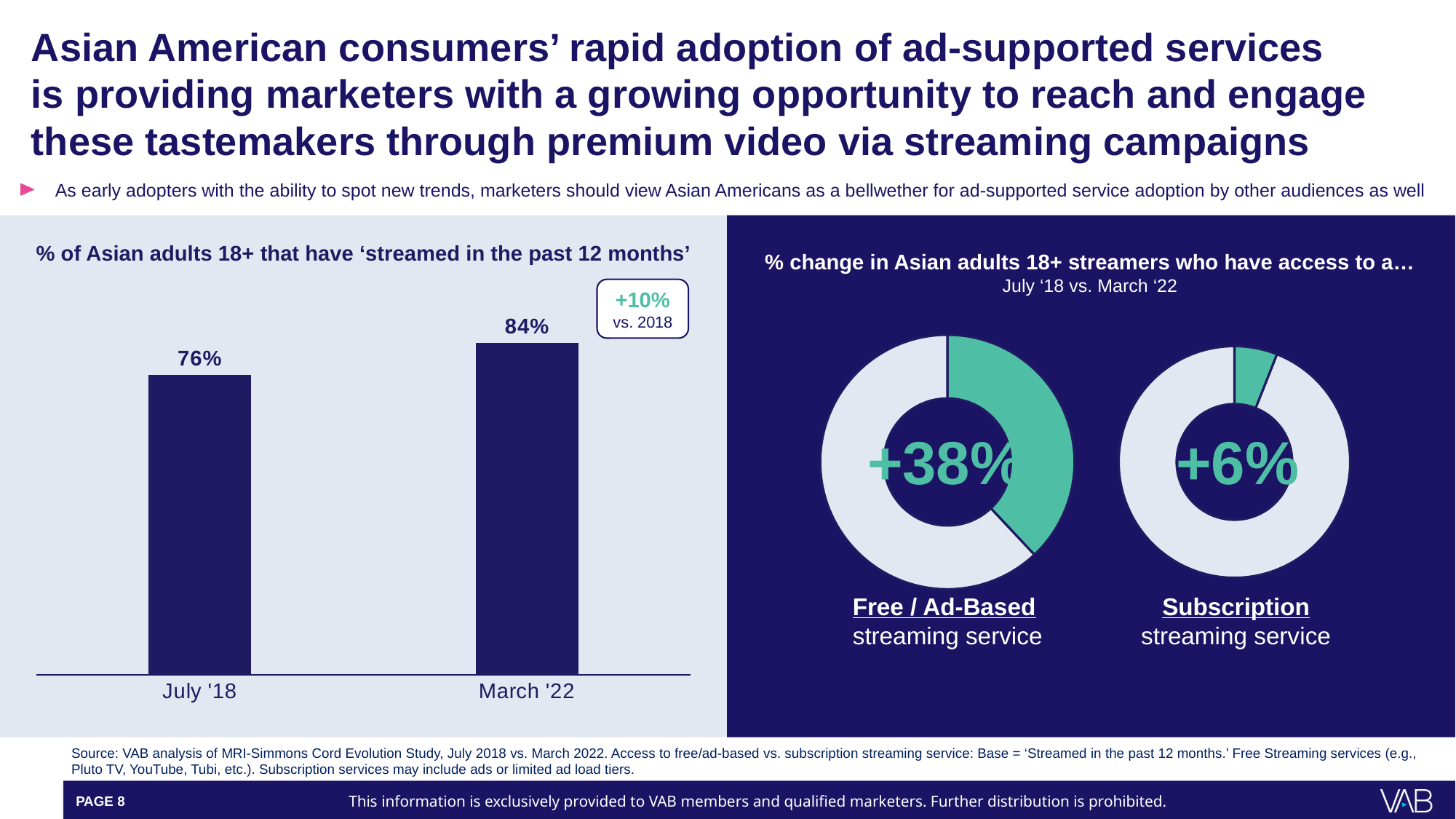
In the bar chart '% of Asian adults 18+ that have streamed in the past 12 months', what is the value for July '18? 76% In the donut charts on the right, which streaming service type shows the larger % change? Free / Ad-Based In the bar chart on the left, do the values rise or fall from July '18 to March '22? Rise In the donut charts on the right, what is the % change for Subscription streaming service access? +6% What kind of chart is shown on the left side of the slide? Bar chart In the bar chart on the left, which period has the lower value? July '18 In the bar chart on the left, what is the difference between the March '22 and July '18 values? 8% In the donut charts on the right, what is the % change for Free / Ad-Based streaming service access? +38% What kind of charts are shown on the right side of the slide? Donut charts In the bar chart on the left, how many bars are plotted? 2 In the bar chart on the left, which period has the higher value? March '22 In the bar chart '% of Asian adults 18+ that have streamed in the past 12 months', what is the value for March '22? 84%